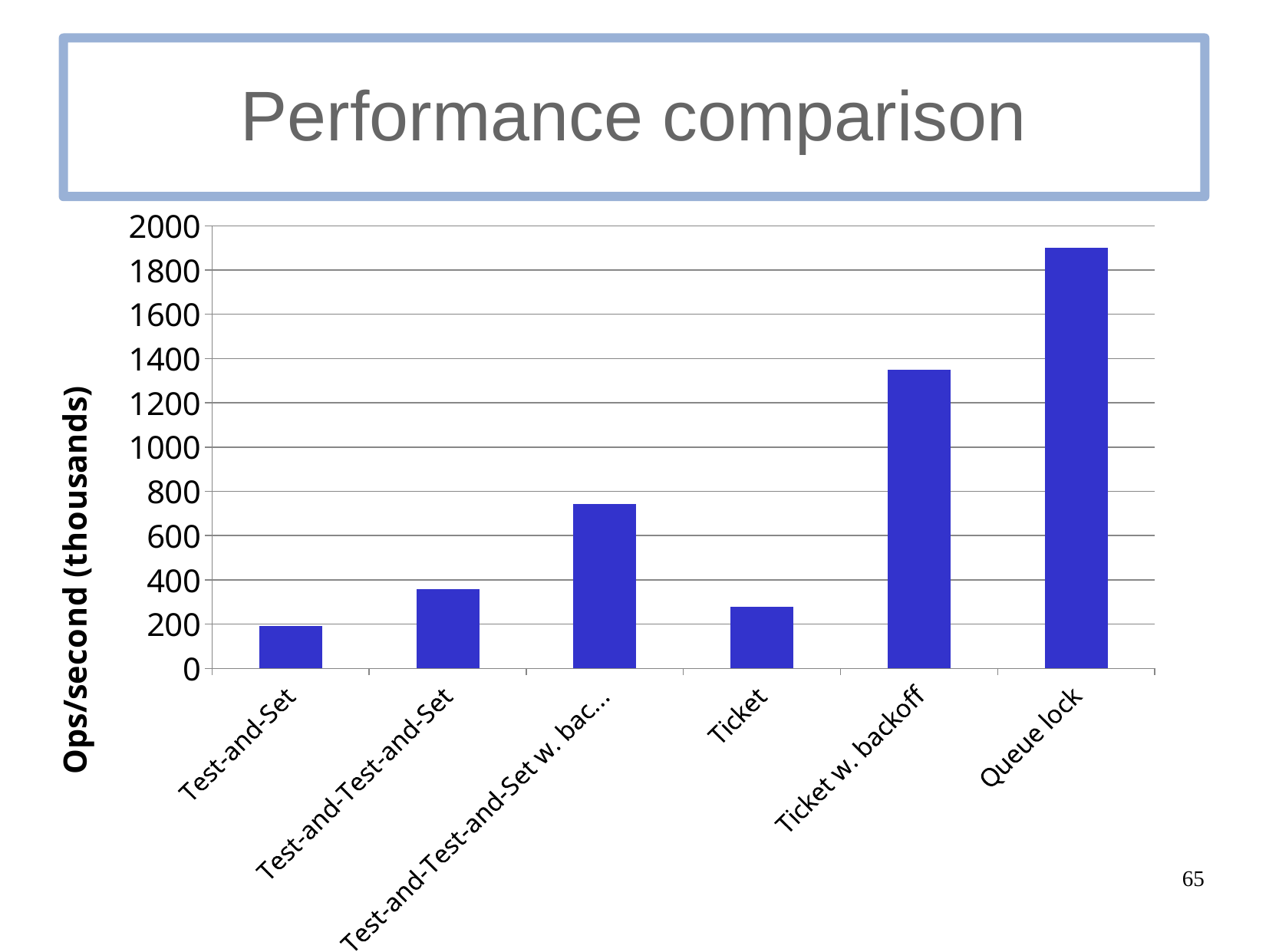
Which is larger, the value for Ticket or the value for Test-and-Test-and-Set? Test-and-Test-and-Set How many categories (bars) are plotted in the chart? 6 What is the label of the vertical axis? Ops/second (thousands) Which is larger, the value for Ticket w. backoff or the value for Queue lock? Queue lock Which category has the highest value? Queue lock Is the value for Queue lock greater or less than 1800? greater Is the value for Ticket w. backoff greater or less than 1200? greater What kind of chart is shown on the slide? bar chart Is the value for Test-and-Test-and-Set w. bac... greater or less than 600? greater Which category has the lowest value? Test-and-Set